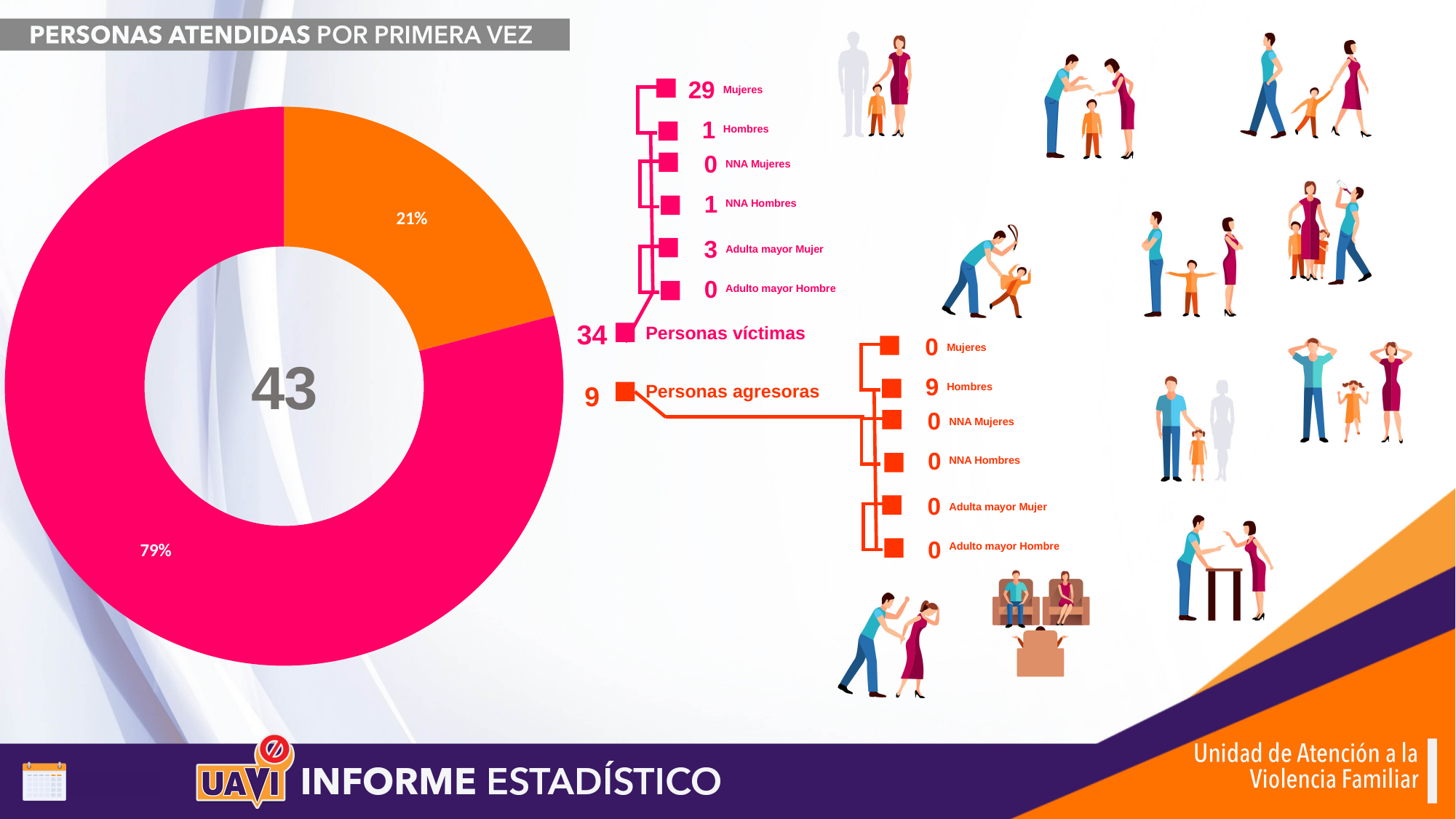
What percentage is shown on the pink slice of the donut chart? 79% How many slices does the donut chart have? 2 Which slice of the donut chart is larger, the pink one or the orange one? The pink one What is the title shown at the top of the slide? PERSONAS ATENDIDAS POR PRIMERA VEZ What is the difference between the number of Personas víctimas and Personas agresoras? 25 What percentage is shown on the orange slice of the donut chart? 21% What is the difference in percentage points between the two slices of the donut chart? 58 What kind of chart is shown on the slide? Donut chart What number is shown in the center of the donut chart? 43 How many Personas víctimas are shown on the slide? 34 How many Personas agresoras are shown on the slide? 9 What colour is the slice of the donut chart that corresponds to Personas agresoras? Orange